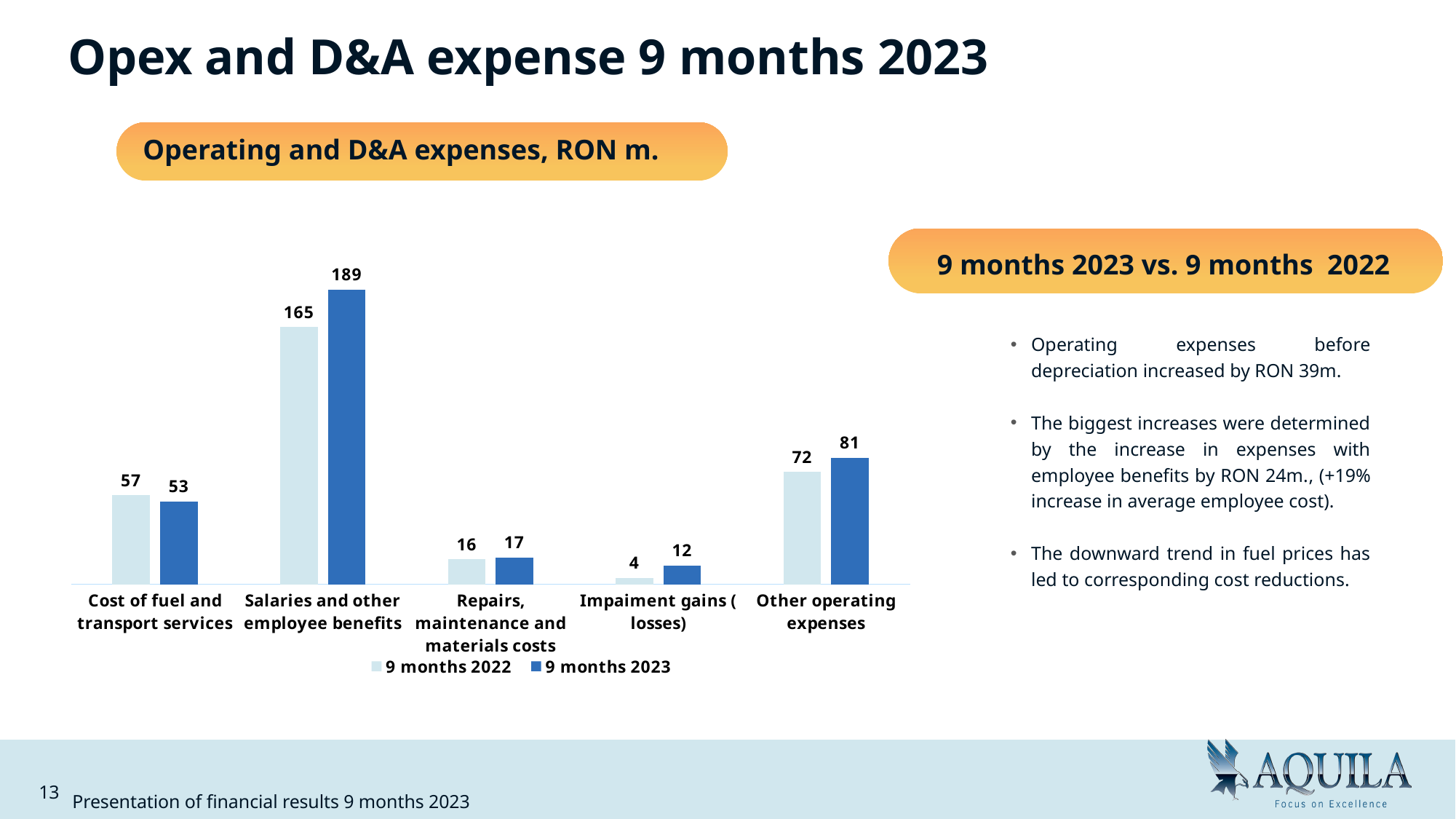
What is the title of the chart? Operating and D&A expenses, RON m. What is the value for Impaiment gains (losses) in 9 months 2023? 12 Which category has the lowest value in 9 months 2022? Impaiment gains (losses) What is the difference between the 9 months 2023 and 9 months 2022 values for Salaries and other employee benefits? 24 Which is larger for Cost of fuel and transport services: 9 months 2022 or 9 months 2023? 9 months 2022 What is the difference between the 9 months 2023 and 9 months 2022 values for Other operating expenses? 9 How many categories are shown on the x axis of the chart? 5 How many series does the legend list? 2 Which category has the highest value in 9 months 2023? Salaries and other employee benefits What kind of chart is shown on the slide? Bar chart What is the value for Cost of fuel and transport services in 9 months 2022? 57 What is the value for Salaries and other employee benefits in 9 months 2023? 189